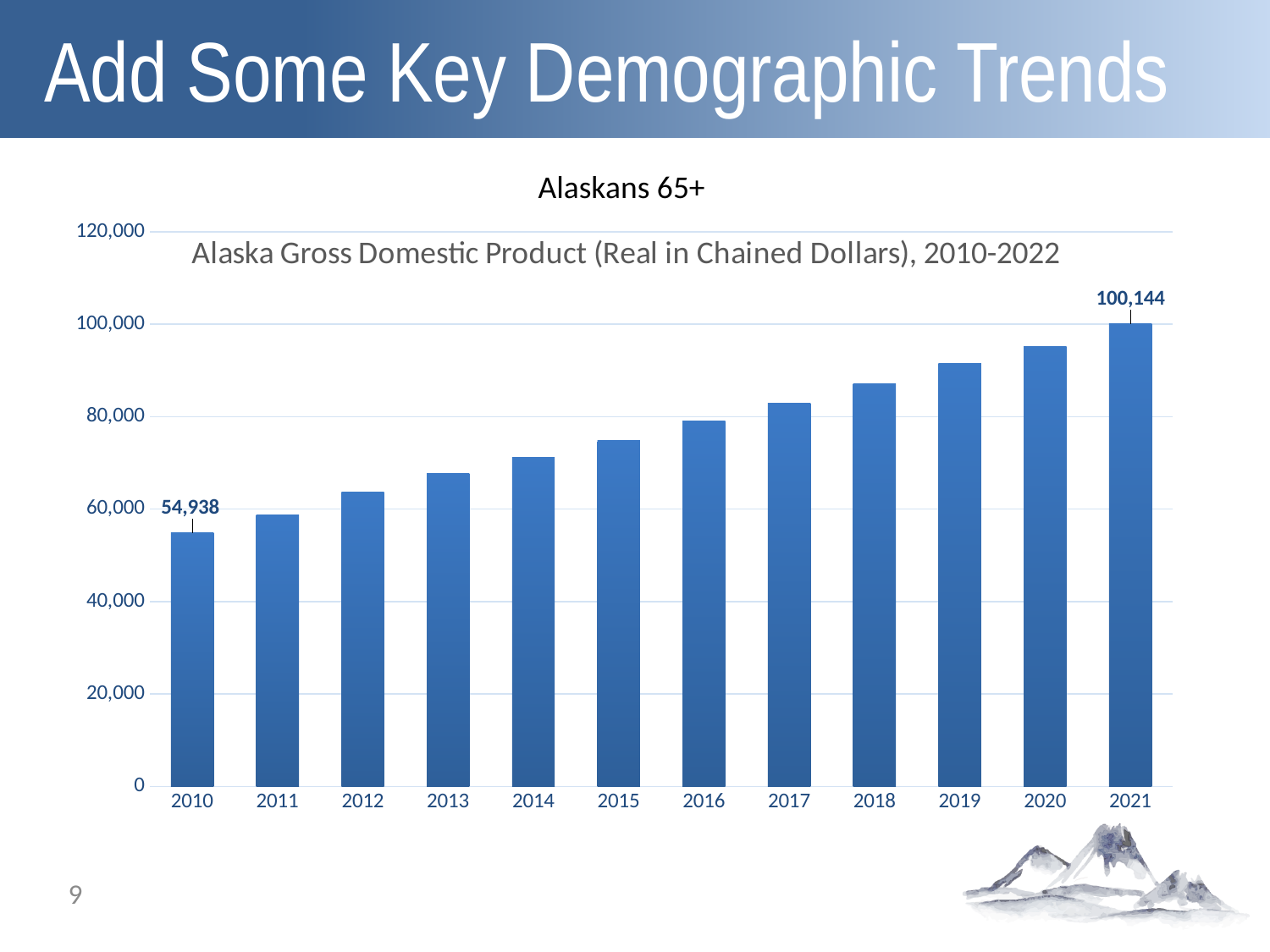
Is the value for 2014 greater or less than 80,000? less Is the value for 2017 greater or less than 80,000? greater Which year has the lowest value? 2010 Which year has the highest value? 2021 What is the difference between the values for 2021 and 2010? 45,206 Do the values rise or fall from 2010 to 2021? rise What kind of chart is shown on the slide? bar chart How many years are shown on the x axis? 12 What is the value for 2010? 54,938 Is the value for 2020 greater or less than 100,000? less What is the value for 2021? 100,144 Which is larger, the value for 2015 or the value for 2018? 2018